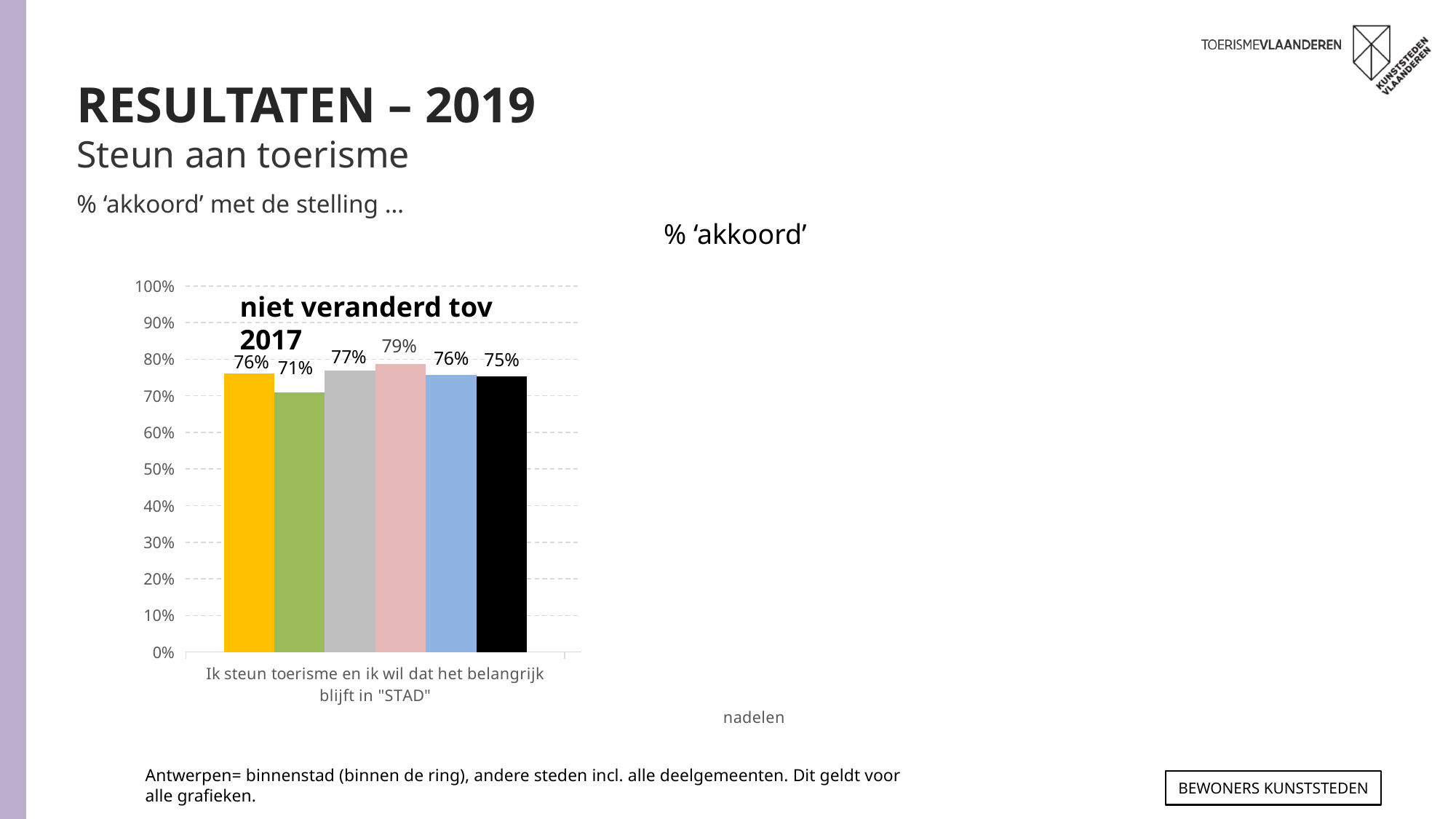
Which bar has the highest value? the pink (fourth) bar, 79% What is the value shown on the yellow (first) bar? 76% What is the title of the chart? % 'akkoord' What is the value shown on the black (last) bar? 75% Which is larger, the value of the grey (third) bar or the value of the black (last) bar? the grey (third) bar, 77% What is the value shown on the pink (fourth) bar? 79% How many bars are plotted in the chart? 6 What type of chart is shown on the slide? bar chart What is the value shown on the green (second) bar? 71% Is the value of the green (second) bar greater or less than 80%? less What is the difference between the highest bar (79%) and the lowest bar (71%)? 8 percentage points Which bar has the lowest value? the green (second) bar, 71%